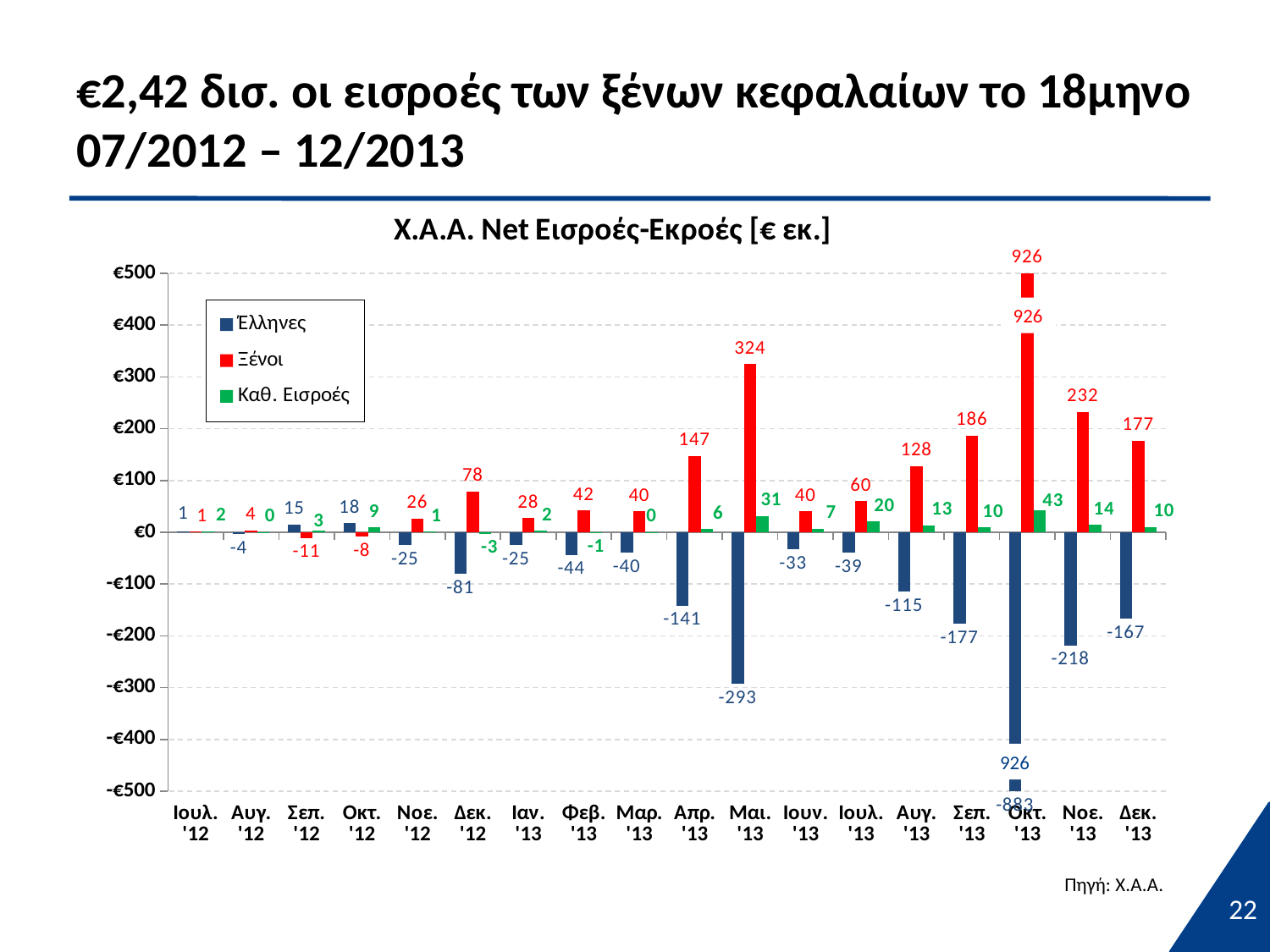
In which month is the Ξένοι value highest? Οκτ. '13 What is the title of the chart? Χ.Α.Α. Net Εισροές-Εκροές [€ εκ.] What type of chart is shown on the slide? bar chart How many series does the legend list? 3 In which month is the Έλληνες value lowest? Οκτ. '13 Is the Έλληνες value for Μαι. '13 greater or less than -€200? less What is the value for Ξένοι in Μαι. '13? 324 What is the difference between the Ξένοι values for Νοε. '13 and Δεκ. '13? 55 What is the value for Έλληνες in Δεκ. '12? -81 What is the value for Καθ. Εισροές in Οκτ. '13? 43 How many months are shown on the x axis? 18 Which is larger, the Ξένοι value for Απρ. '13 or for Αυγ. '13? Απρ. '13